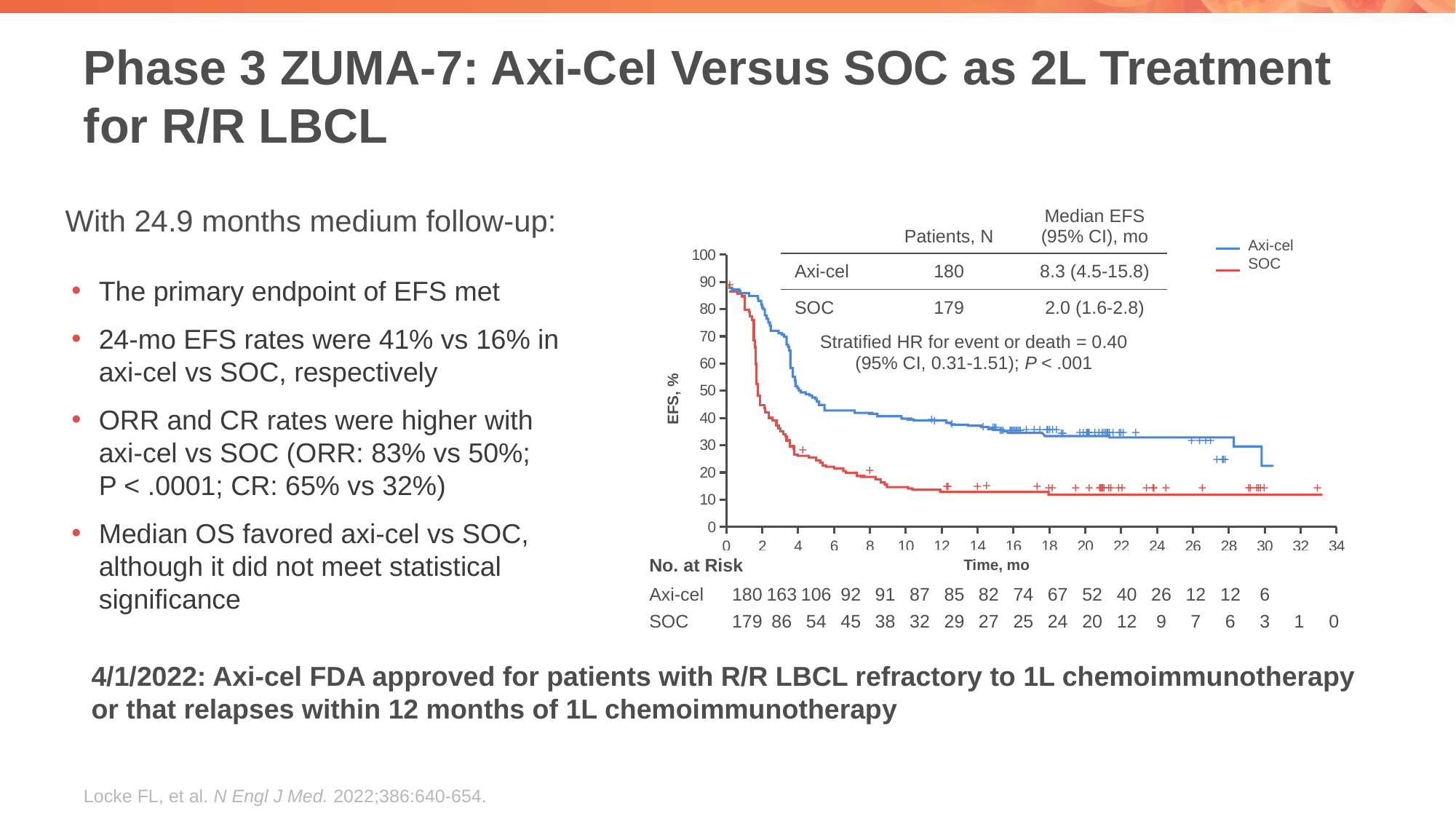
What is the median EFS (95% CI) in months for Axi-cel shown in the chart's table? 8.3 (4.5-15.8) What colour is the Axi-cel curve in the EFS chart? blue At 12 months, which curve shows a higher EFS, Axi-cel or SOC? Axi-cel How many patients (N) are in the SOC arm according to the chart's table? 179 What is the median EFS (95% CI) in months for SOC shown in the chart's table? 2.0 (1.6-2.8) What kind of chart is used to show EFS over time? line chart Is the EFS value for SOC at 24 months greater or less than 20? less How many Axi-cel patients were at risk at 10 months? 87 What is the difference in Patients, N between the Axi-cel and SOC arms? 1 How many series does the legend of the EFS chart list? 2 What is the stratified HR for event or death shown on the chart? 0.40 How many SOC patients were at risk at 4 months? 54